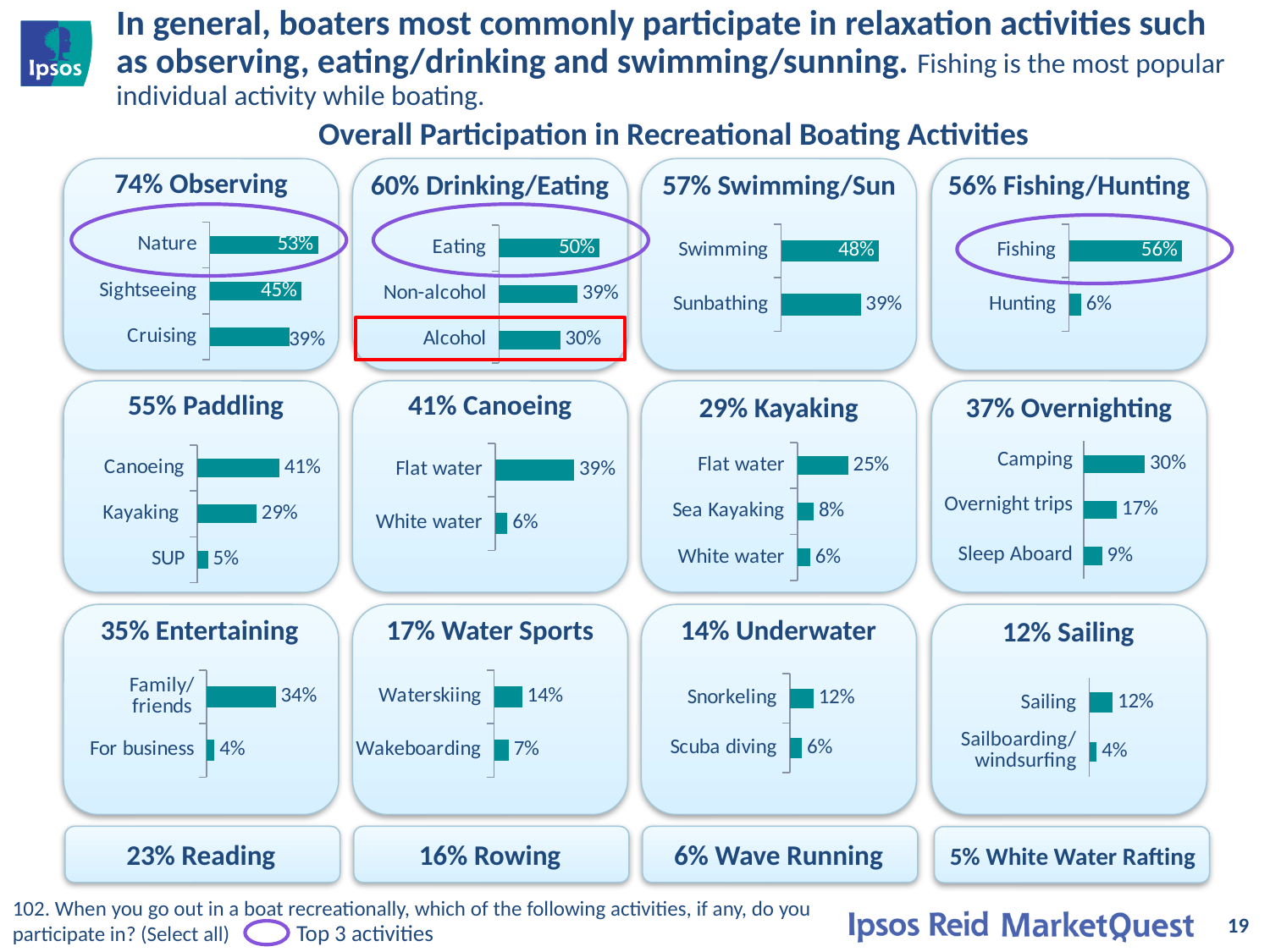
What kind of chart is used in the "14% Underwater" panel? Bar chart In the "56% Fishing/Hunting" chart, which category has the lowest value? Hunting In the "12% Sailing" chart, what is the value for Sailboarding/windsurfing? 4% In the "37% Overnighting" chart, which category has the highest value? Camping In the "17% Water Sports" chart, what is the value for Wakeboarding? 7% In the "35% Entertaining" chart, what is the difference between Family/friends and For business? 30% In the "60% Drinking/Eating" chart, what is the value for Alcohol? 30% In the "41% Canoeing" chart, which is larger, Flat water or White water? Flat water In the "29% Kayaking" chart, what is the value for Sea Kayaking? 8% In the "57% Swimming/Sun" chart, what is the difference between Swimming and Sunbathing? 9% In the "55% Paddling" chart, how many categories are shown? 3 In the "74% Observing" chart, what is the value for Sightseeing? 45%